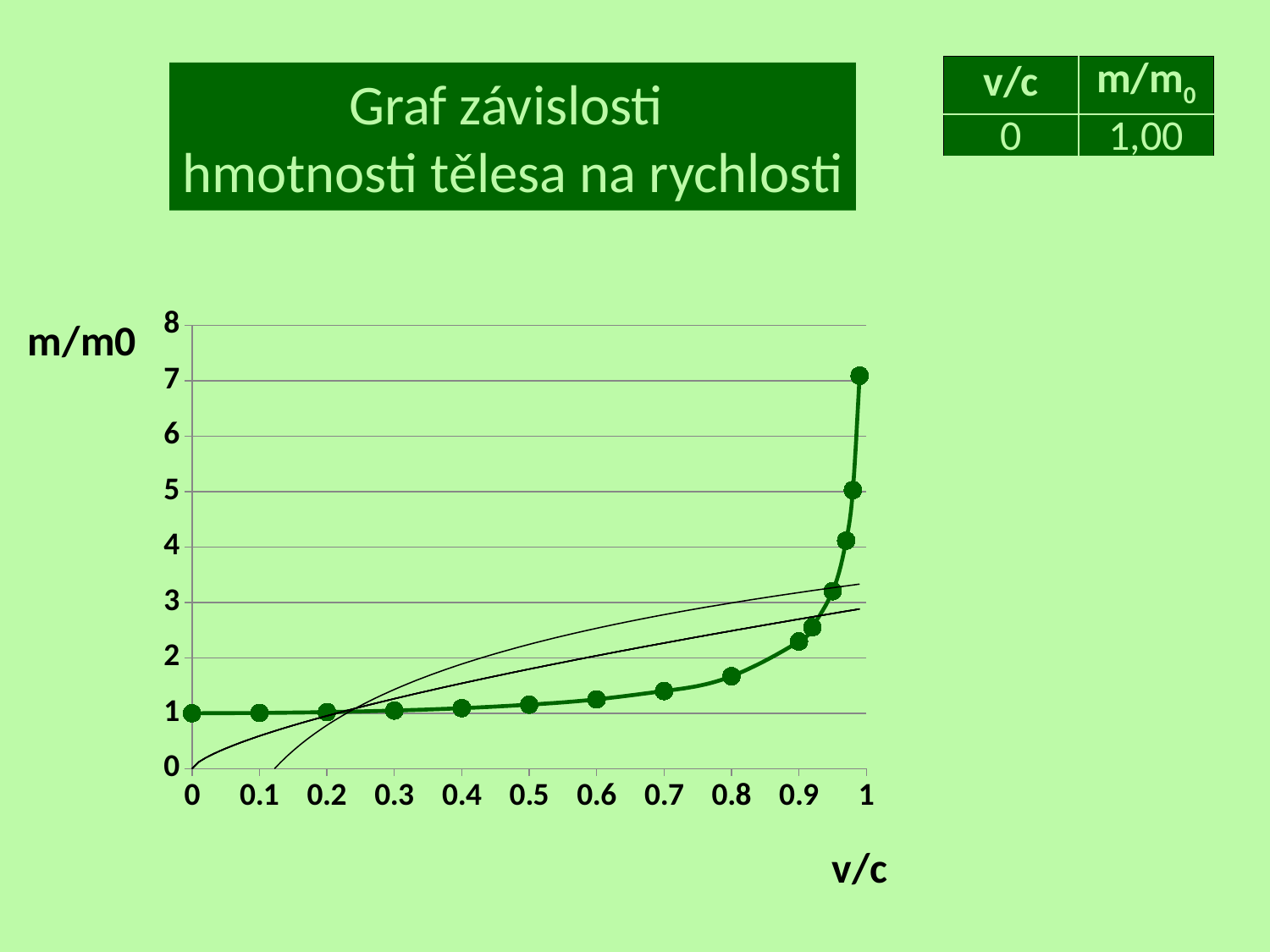
What is the title of the chart? Graf závislosti hmotnosti tělesa na rychlosti Which is larger, the value of m/m0 at v/c = 0.9 or at v/c = 0.5? v/c = 0.9 What is the value of m/m0 at v/c = 0? 1,00 What kind of chart is shown on the slide? line chart Is the value of m/m0 at v/c = 0.5 greater or less than 2? less At which end of the v/c axis is the highest plotted value of m/m0 found? near v/c = 1 Which is larger, the value of m/m0 at v/c = 0.3 or at v/c = 0.8? v/c = 0.8 Is the value of m/m0 at v/c = 0.9 greater or less than 2? greater Is the highest plotted value of m/m0 greater or less than 6? greater What label is shown on the vertical axis of the chart? m/m0 Do the plotted values of m/m0 rise or fall as v/c increases? rise